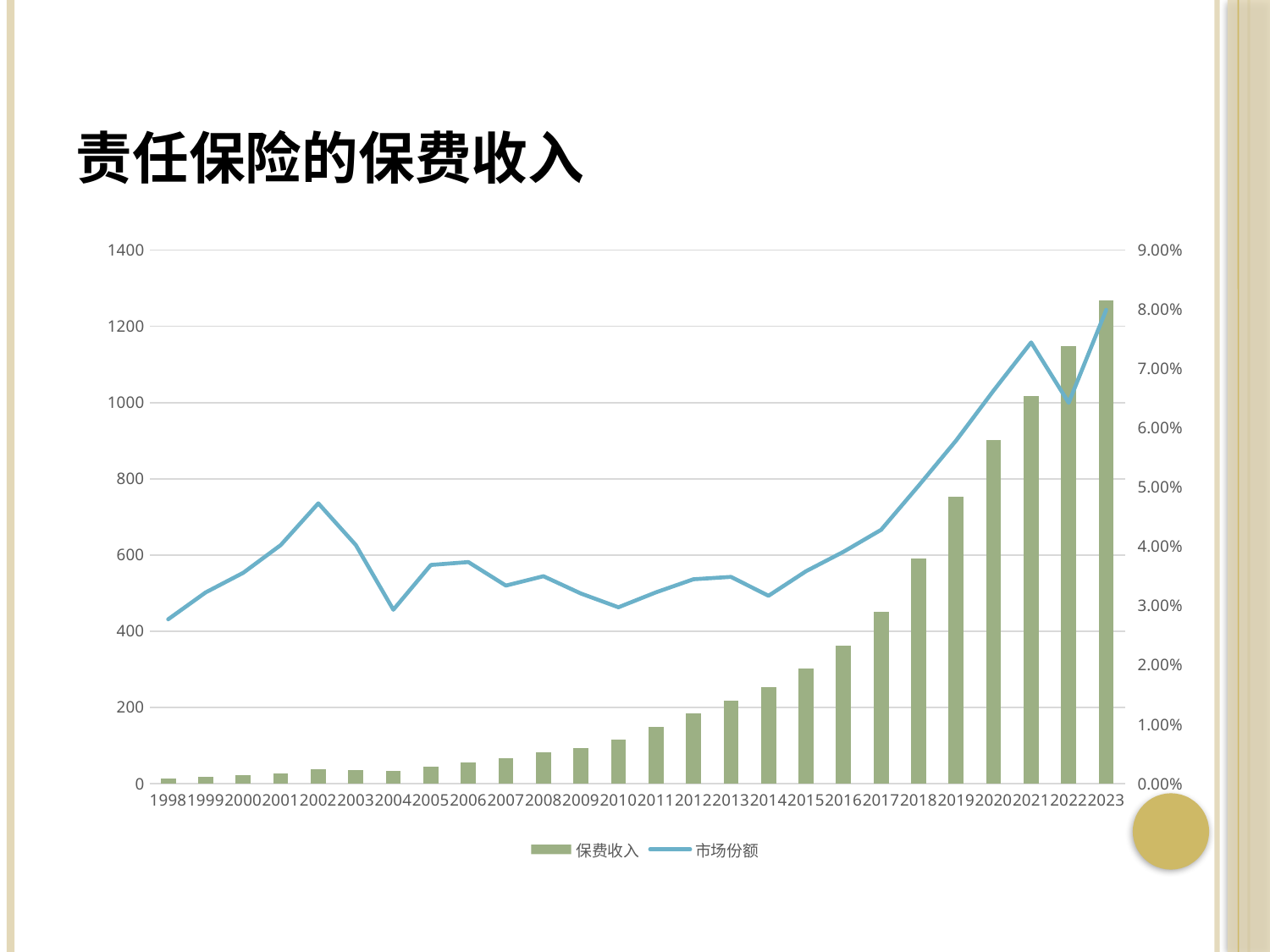
What is the title of the chart on the slide? 责任保险的保费收入 Is the 市场份额 value for 2014 greater or less than 4.00%? less Is the 保费收入 value for 2023 greater or less than 1200? greater Which year has the highest 保费收入 bar? 2023 Which year has the lowest 保费收入 bar? 1998 How many series does the legend list? 2 Is the 市场份额 value for 2002 greater or less than 4.00%? greater Which year has the higher 市场份额, 2021 or 2022? 2021 How many years are shown along the x axis? 26 What kind of chart is shown on the slide? bar and line chart Do the 保费收入 bars generally rise or fall from 1998 to 2023? rise